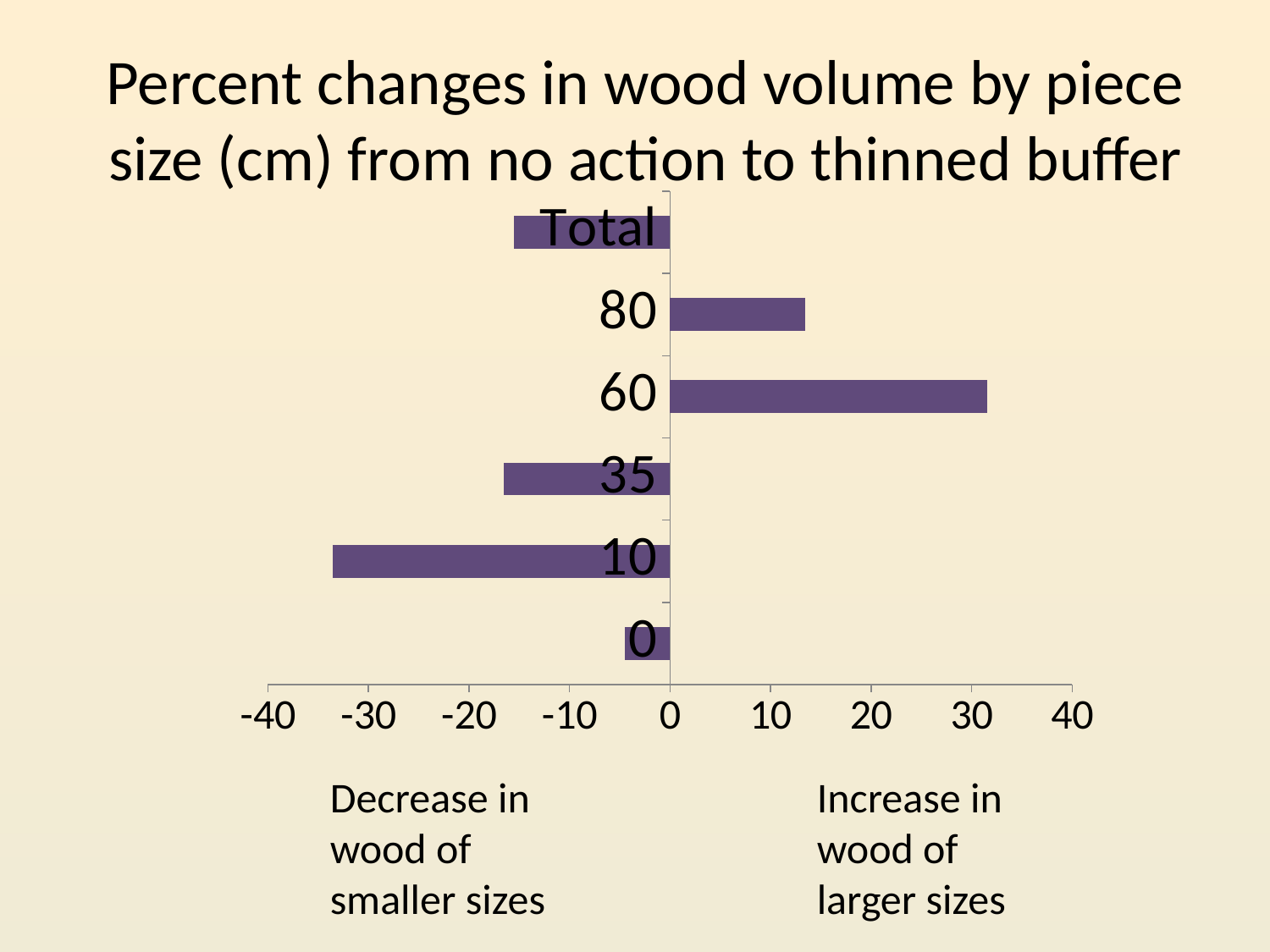
Which has the larger value, the 60 cm category or the 80 cm category? 60 Which category has the highest value? 60 Is the value for the 10 cm category greater or less than -30? less Is the value for the 80 cm category greater or less than 10? greater Is the value for the 35 cm category greater or less than -10? less What kind of chart is shown on the slide? bar chart Which category has the lowest value? 10 How many categories show a positive (increase) value? 2 What is the title of the chart? Percent changes in wood volume by piece size (cm) from no action to thinned buffer How many categories are plotted on the chart? 6